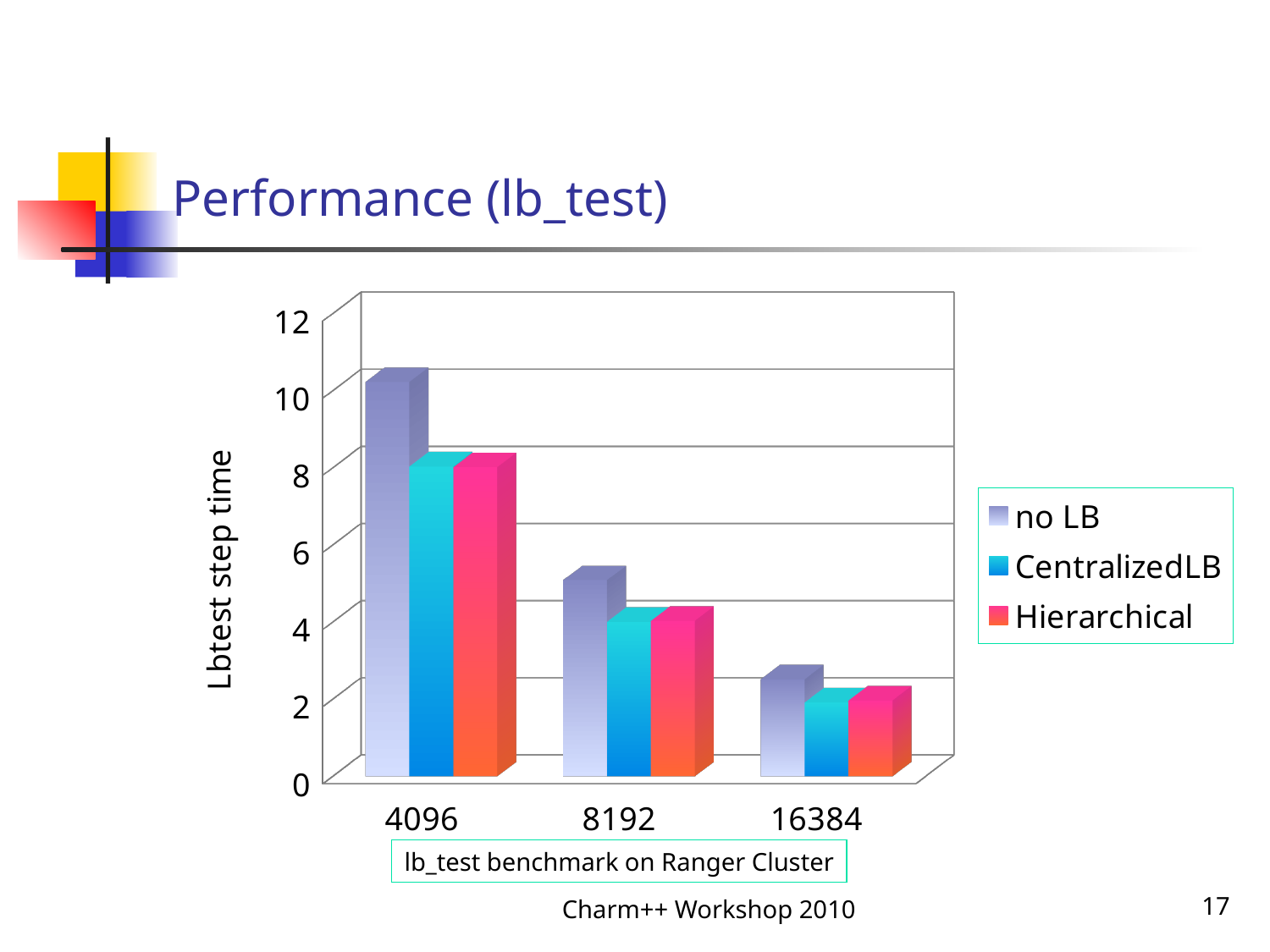
Is the no LB value at 4096 greater or less than 8? greater What kind of chart is shown on the slide? bar chart Is the CentralizedLB value at 4096 greater or less than 10? less At which x-axis category is the no LB bar the lowest? 16384 Is the Hierarchical value at 16384 greater or less than 4? less What is the label on the y axis of the chart? Lbtest step time At 8192, which is larger: the no LB value or the CentralizedLB value? no LB Do the no LB values rise or fall as the x-axis category increases from 4096 to 16384? fall Which series has the highest bar at 4096? no LB How many categories are shown on the x axis? 3 How many series does the legend list? 3